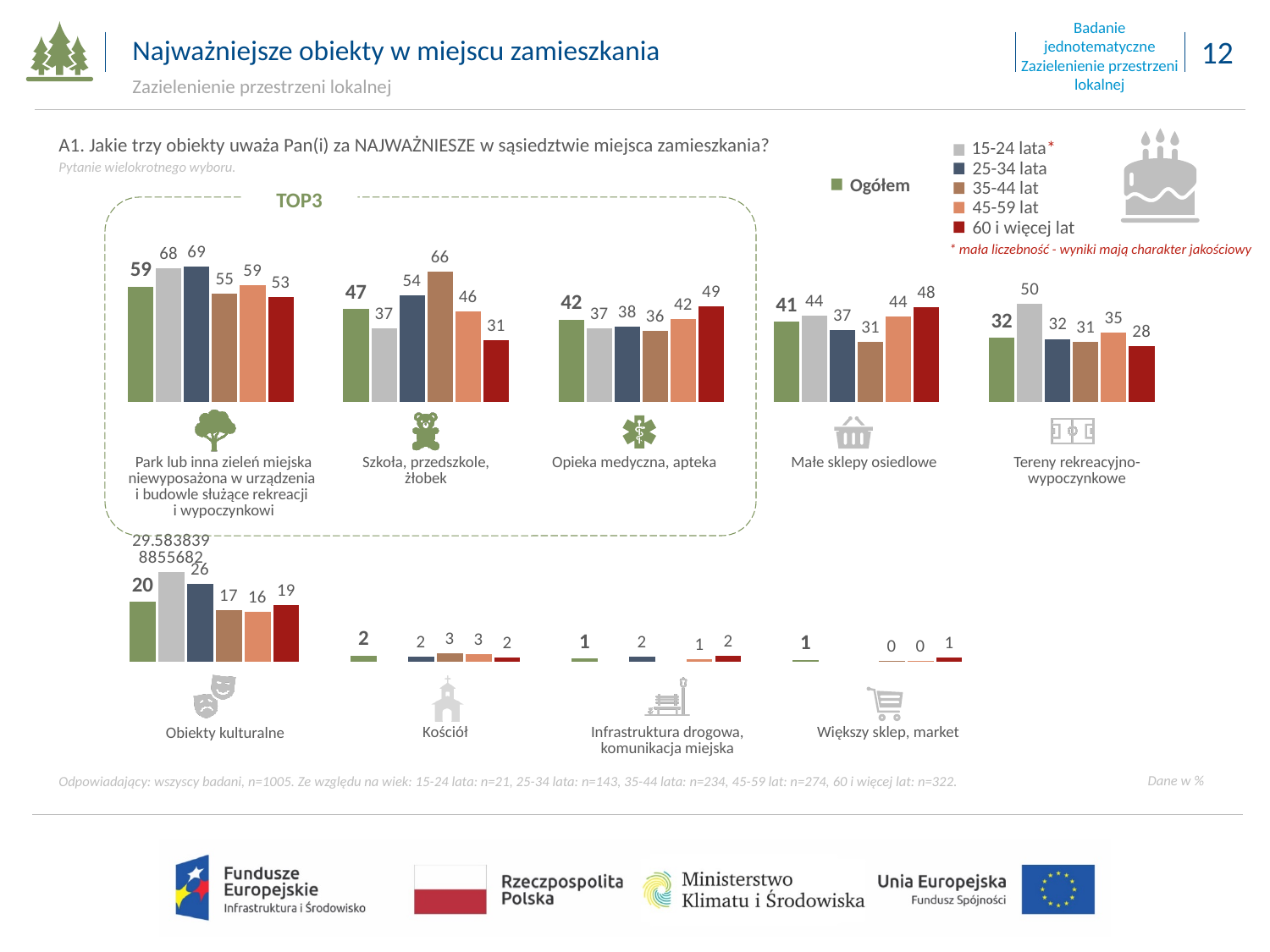
What kind of chart is shown on the slide? Bar chart Which category has the highest Ogółem (overall) value? Park lub inna zieleń miejska niewyposażona w urządzenia i budowle służące rekreacji i wypoczynkowi What is the value for the 35-44 lat group for 'Szkoła, przedszkole, żłobek'? 66 What is the value for the 60 i więcej lat group for 'Opieka medyczna, apteka'? 49 How many series does the legend list? 6 What is the Ogółem (overall) value for 'Małe sklepy osiedlowe'? 41 Which age group has the lowest value for 'Szkoła, przedszkole, żłobek'? 60 i więcej lat What is the value for the 15-24 lata group for 'Tereny rekreacyjno-wypoczynkowe'? 50 What is the difference between the 25-34 lata value and the 60 i więcej lat value for 'Park lub inna zieleń miejska'? 16 What is the Ogółem (overall) value for 'Park lub inna zieleń miejska niewyposażona w urządzenia i budowle służące rekreacji i wypoczynkowi'? 59 Which three categories are marked as TOP3 on the slide? Park lub inna zieleń miejska; Szkoła, przedszkole, żłobek; Opieka medyczna, apteka For 'Małe sklepy osiedlowe', which is larger: the value for 15-24 lata or the value for 35-44 lat? 15-24 lata